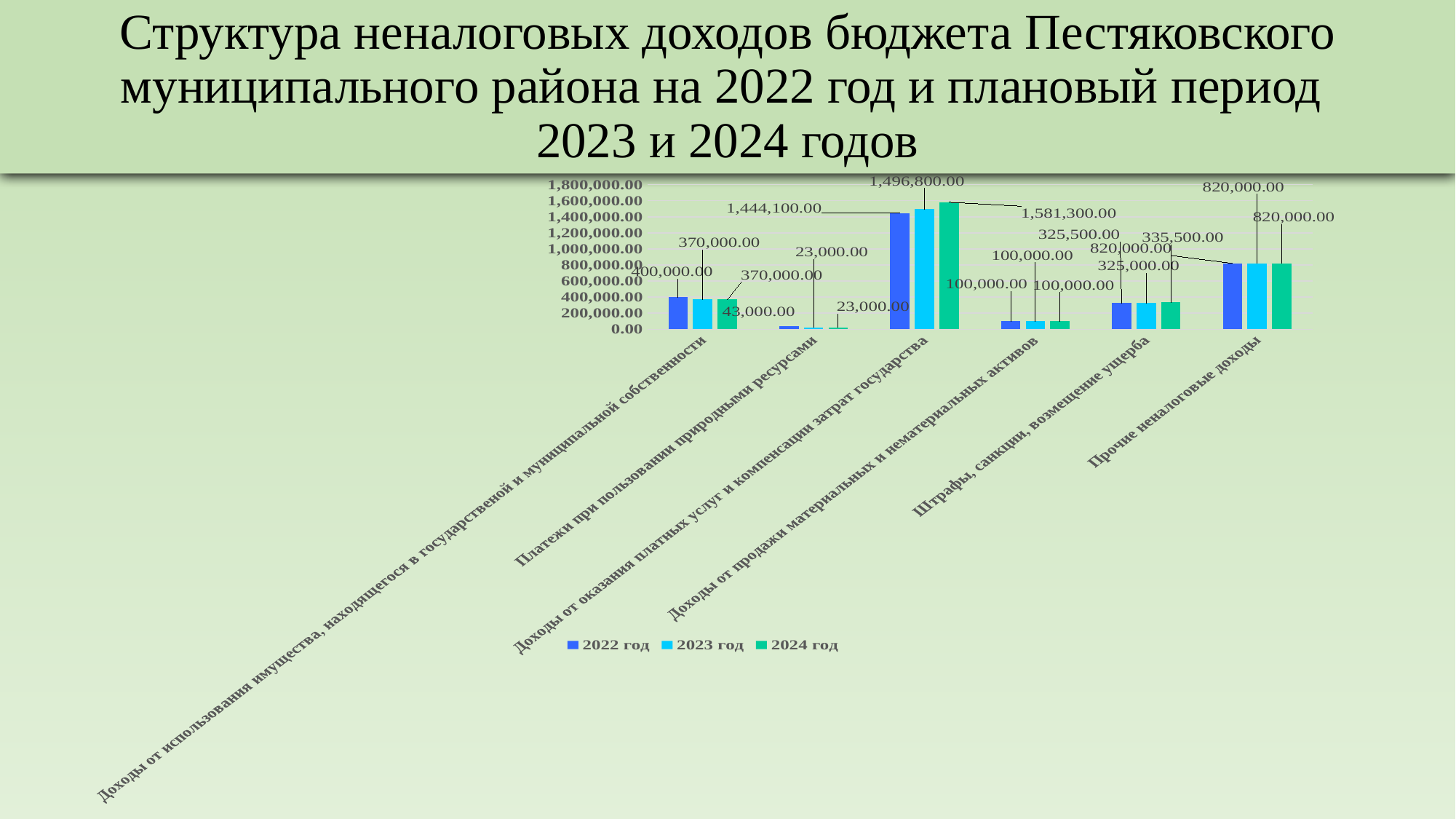
What is the value for 2024 год for Штрафы, санкции, возмещение ущерба? 335,500.00 Which is larger for 2022 год: Прочие неналоговые доходы or Штрафы, санкции, возмещение ущерба? Прочие неналоговые доходы What is the value for 2024 год for Доходы от оказания платных услуг и компенсации затрат государства? 1,581,300.00 What is the value for 2022 год for Доходы от использования имущества, находящегося в государственной и муниципальной собственности? 400,000.00 How many categories are shown on the x axis? 6 Which category has the highest value for 2022 год? Доходы от оказания платных услуг и компенсации затрат государства What kind of chart is shown on the slide? bar chart Which category has the lowest value for 2023 год? Платежи при пользовании природными ресурсами How many series does the legend list? 3 Do the values for Доходы от оказания платных услуг и компенсации затрат государства rise or fall from 2022 год to 2024 год? rise What are the three entries in the legend? 2022 год, 2023 год, 2024 год What is the difference between the 2024 год and 2022 год values for Доходы от оказания платных услуг и компенсации затрат государства? 137,200.00